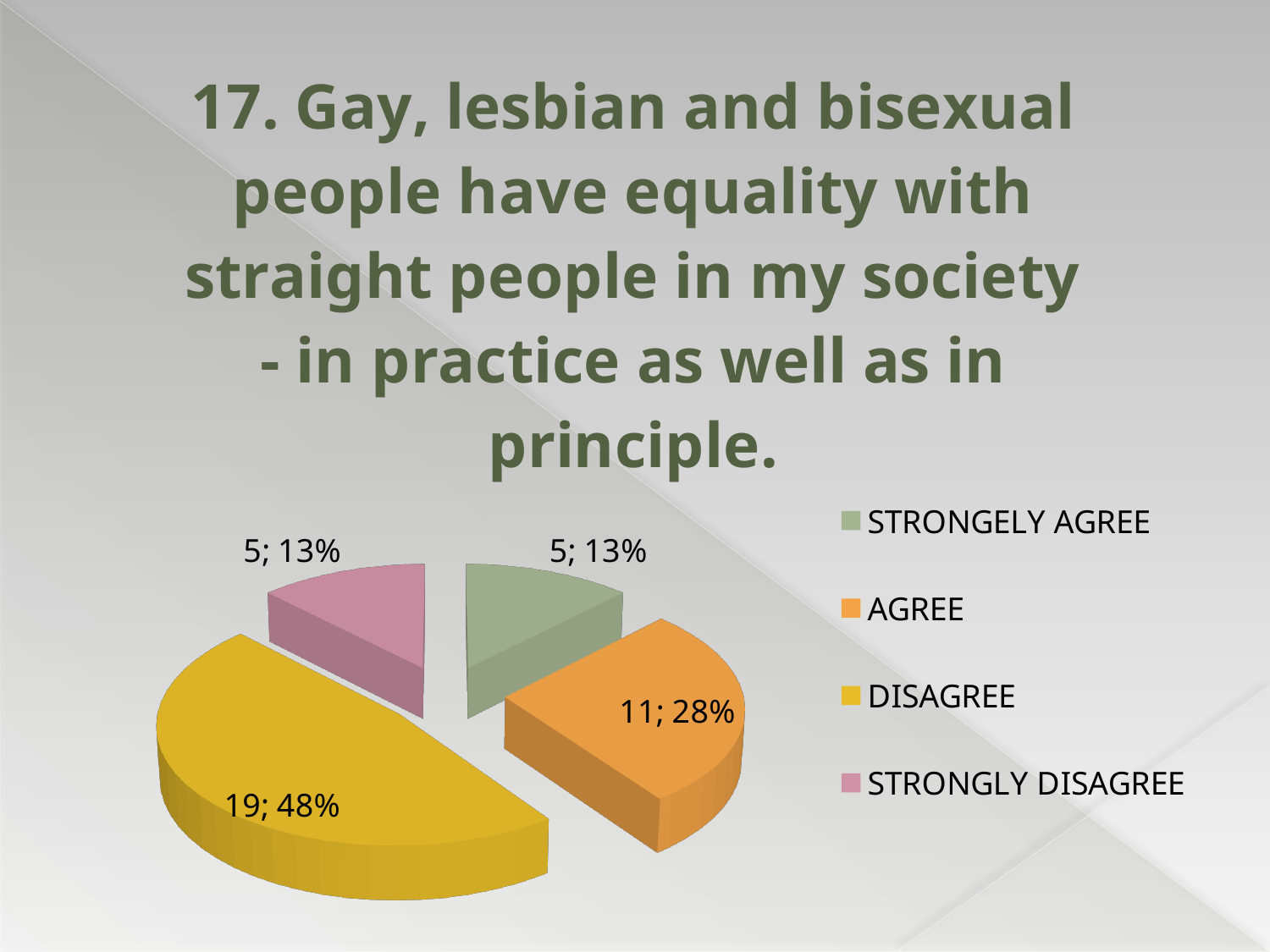
What colour is the DISAGREE slice? yellow What is the count for STRONGLY AGREE? 5 What is the count for DISAGREE? 19 Which category has the largest slice? DISAGREE How many slices does the pie chart have? 4 What share of the pie does DISAGREE represent? 48% What is the count for AGREE? 11 What kind of chart is shown on the slide? pie chart Which is larger, the count for AGREE or the count for STRONGLY DISAGREE? AGREE How many entries does the legend list? 4 What is the difference between the counts for DISAGREE and AGREE? 8 What share of the pie does AGREE represent? 28%